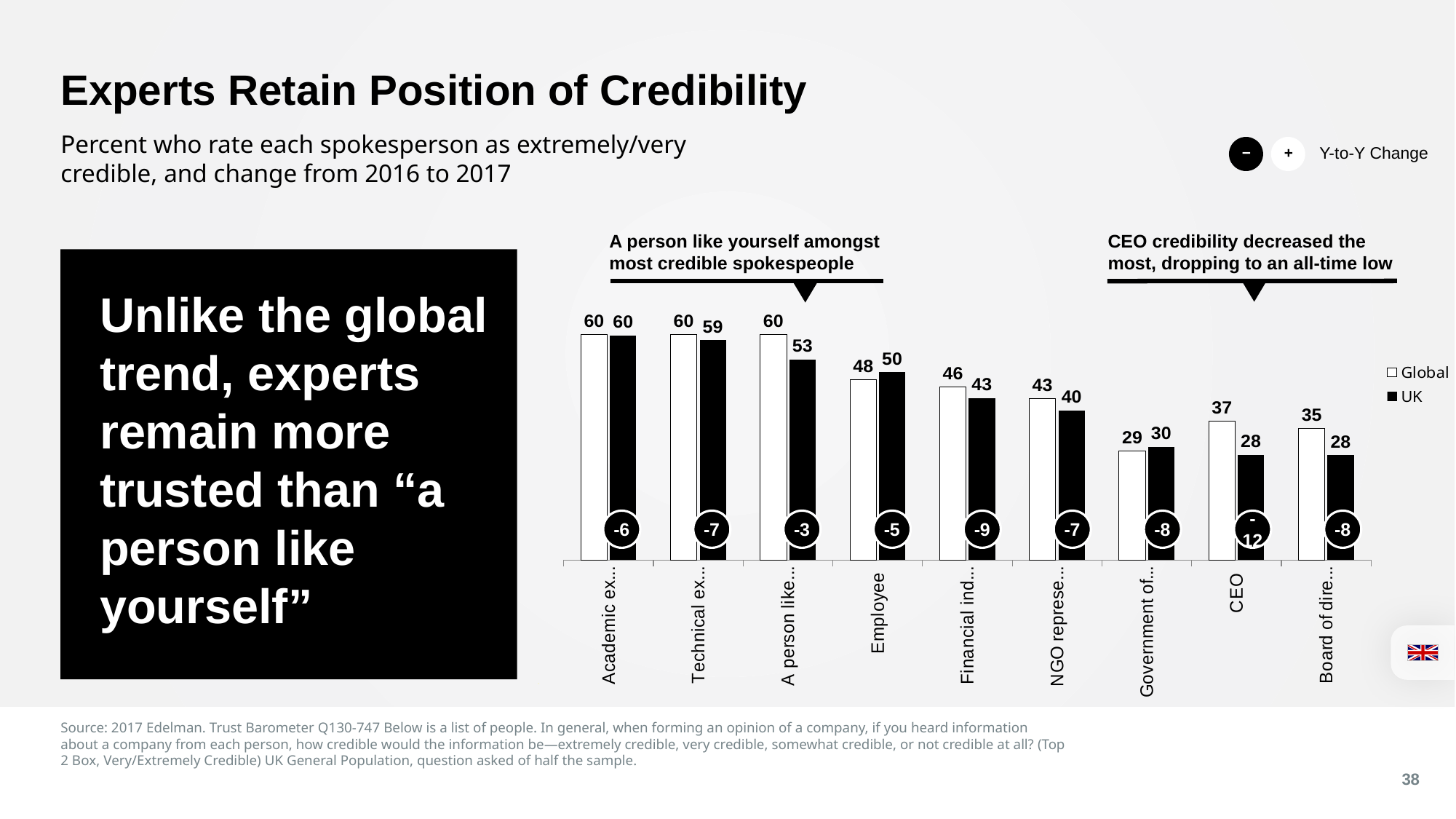
How many categories are shown on the x axis? 9 What is the year-to-year change shown for CEO? -12 What is the UK value for Employee? 50 What is the Global value for Employee? 48 Which is larger for Employee, the Global value or the UK value? UK What is the Global value for CEO? 37 What is the year-to-year change shown for Employee? -5 What is the UK value for CEO? 28 What is the difference between the Global and UK values for CEO? 9 Which series is shown with black bars? UK What kind of chart is shown on the slide? Bar chart How many series does the legend list? 2